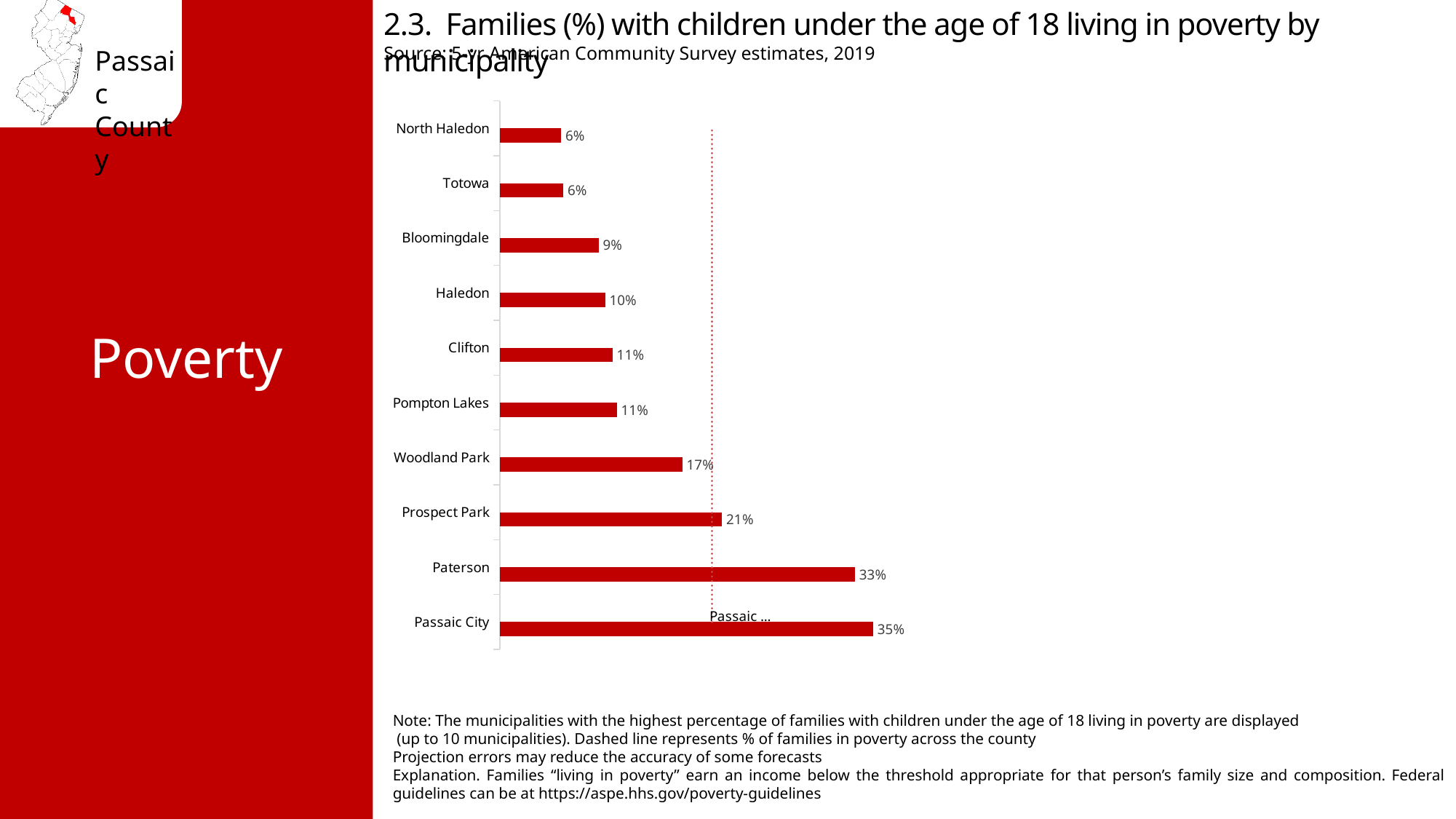
What does the dashed vertical line on the chart represent? % of families in poverty across the county How many municipalities are shown in the chart? 10 Which has a higher value, Clifton or Bloomingdale? Clifton What is the difference between Prospect Park and Haledon? 11% Which has a higher value, Prospect Park or Woodland Park? Prospect Park What is the difference in percentage points between Passaic City and Paterson? 2% What percentage of families with children under 18 are living in poverty in Passaic City? 35% Which municipality has the highest percentage of families with children under 18 living in poverty? Passaic City What is the value shown for Bloomingdale? 9% What is the value shown for Paterson? 33% What type of chart is used on this slide? Bar chart What is the value shown for Woodland Park? 17%